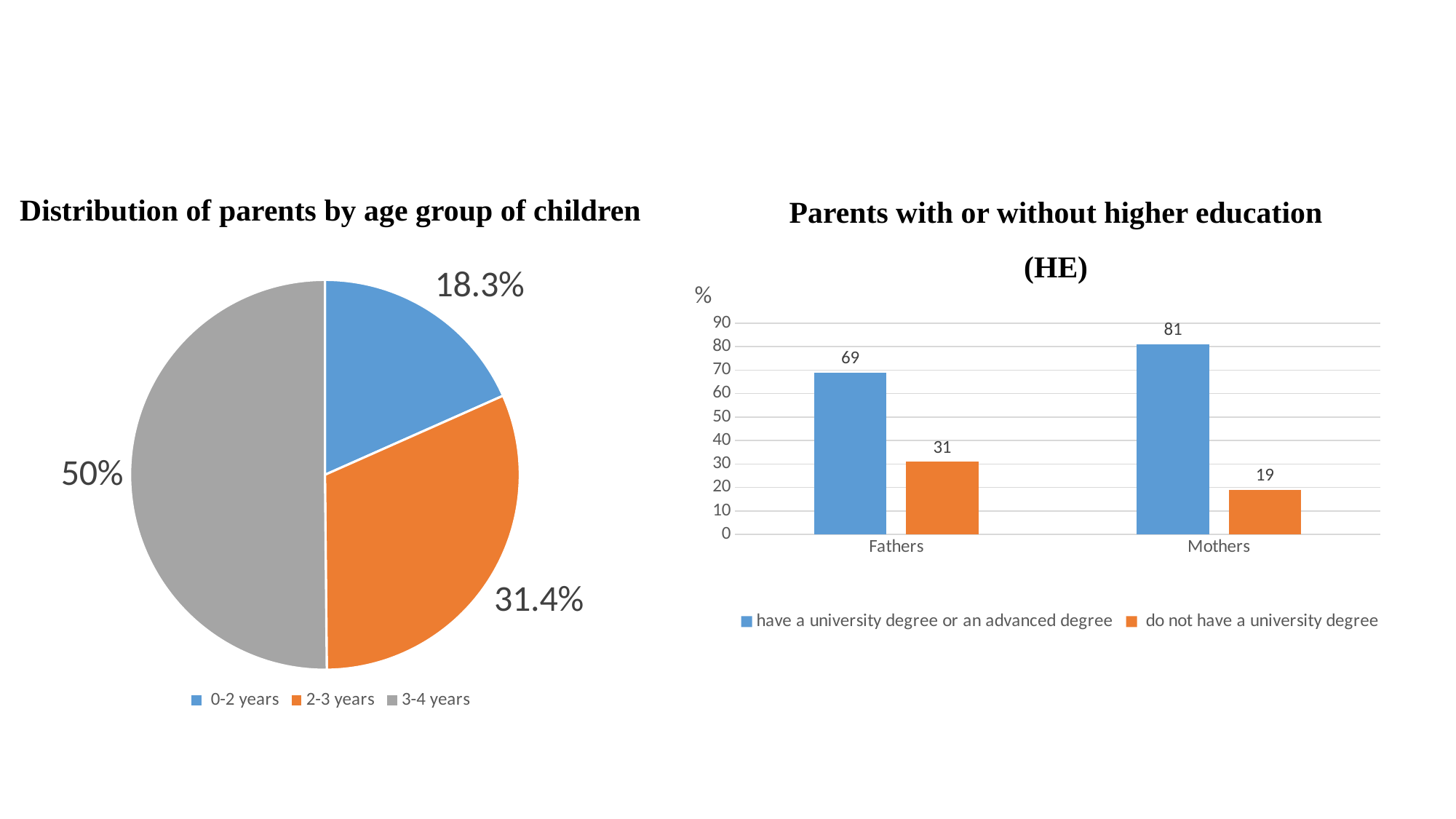
In the 'Distribution of parents by age group of children' chart, which age group has the smallest share? 0-2 years What kind of chart is 'Distribution of parents by age group of children'? pie chart In the 'Distribution of parents by age group of children' chart, what share of parents have children aged 0-2 years? 18.3% In the 'Parents with or without higher education (HE)' chart, who has the higher percentage without a university degree, fathers or mothers? Fathers In the 'Parents with or without higher education (HE)' chart, what is the difference between the percentage of mothers and fathers who have a university degree or an advanced degree? 12 How many series does the legend of the 'Parents with or without higher education (HE)' chart list? 2 In the 'Distribution of parents by age group of children' chart, what share of parents have children aged 2-3 years? 31.4% In the 'Parents with or without higher education (HE)' chart, what percentage of fathers have a university degree or an advanced degree? 69 What kind of chart is 'Parents with or without higher education (HE)'? bar chart In the 'Distribution of parents by age group of children' chart, how many age groups are shown? 3 In the 'Distribution of parents by age group of children' chart, which age group has the largest share? 3-4 years In the 'Parents with or without higher education (HE)' chart, what percentage of mothers do not have a university degree? 19